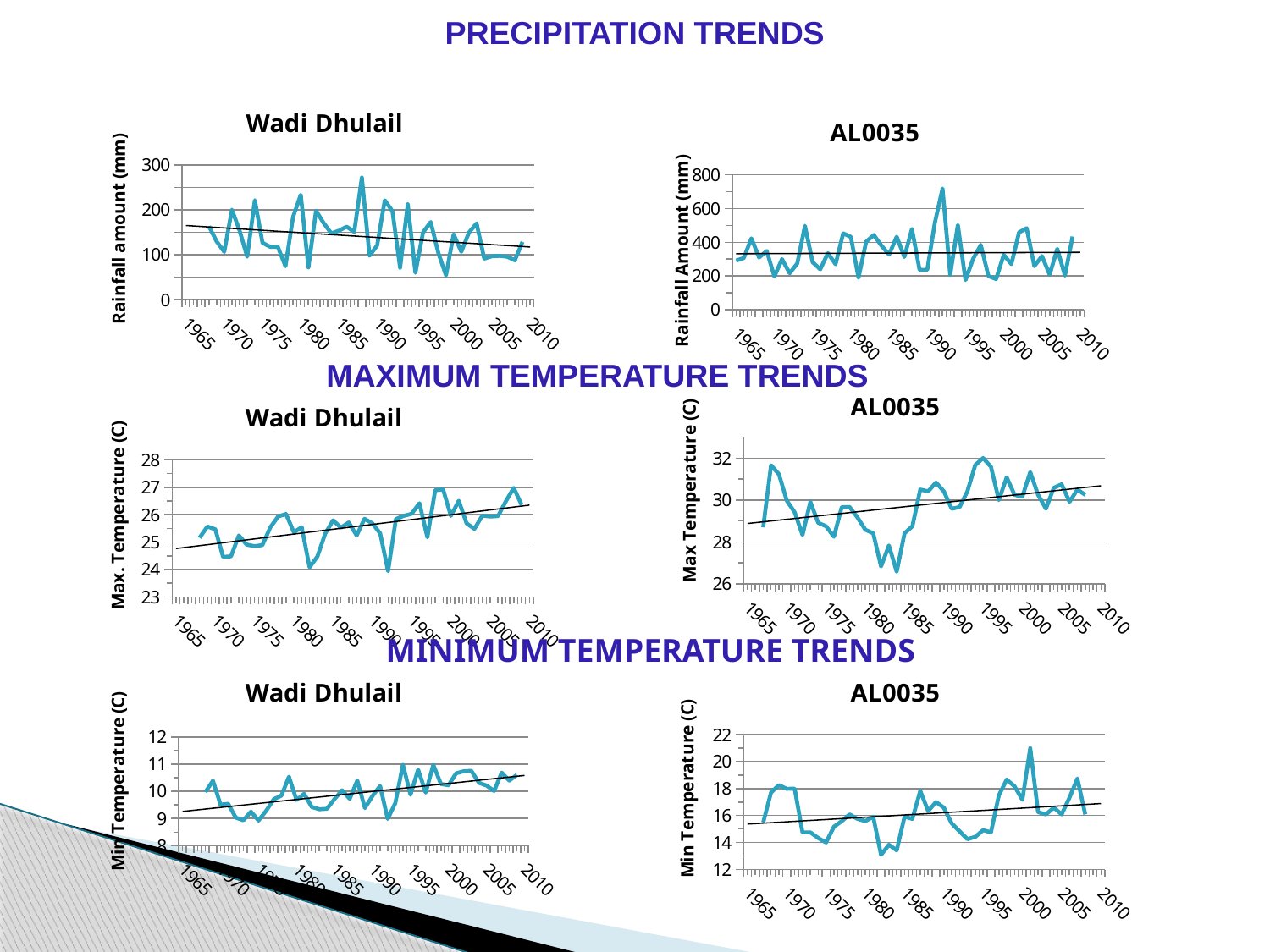
In the AL0035 minimum temperature chart, is the highest peak of the temperature line greater or less than 20? greater In the AL0035 chart under MAXIMUM TEMPERATURE TRENDS, does the straight trend line rise or fall from 1965 to 2010? rise In the AL0035 precipitation chart, is the highest peak of the rainfall line greater or less than 600? greater In the Wadi Dhulail precipitation chart, is the highest peak of the rainfall line greater or less than 200? greater What kind of chart is the Wadi Dhulail chart under PRECIPITATION TRENDS? line chart How many charts are shown on the slide? 6 What is the y-axis label of the Wadi Dhulail precipitation chart? Rainfall amount (mm) In the Wadi Dhulail chart under MINIMUM TEMPERATURE TRENDS, does the straight trend line rise or fall from 1965 to 2010? rise In the AL0035 chart under MINIMUM TEMPERATURE TRENDS, does the straight trend line rise or fall from 1965 to 2010? rise